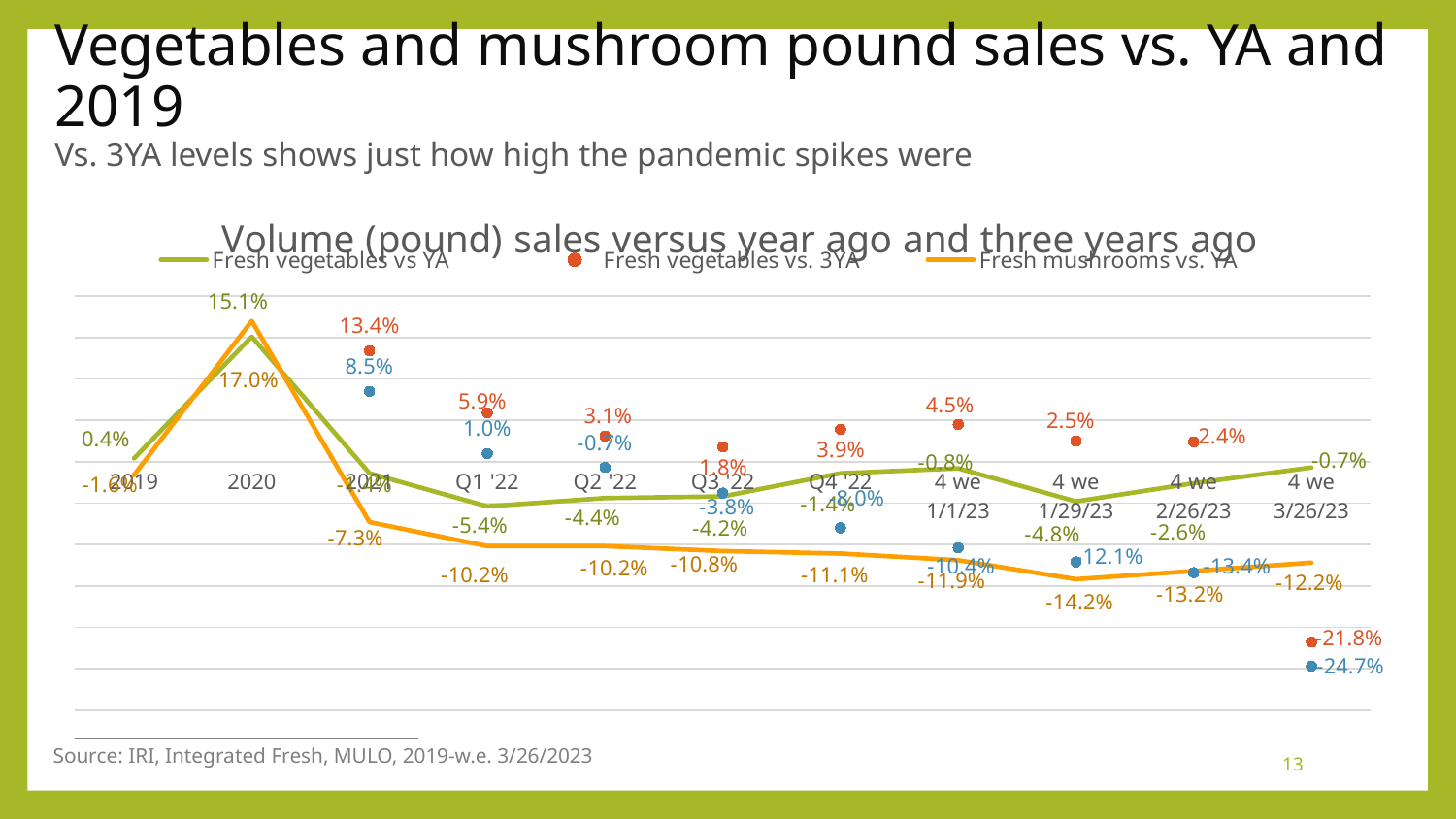
What is the difference between the Fresh mushrooms vs. YA values for Q4 '22 and the 4 weeks ending 1/1/23? 0.8 percentage points What is the title of the chart? Volume (pound) sales versus year ago and three years ago In which period is Fresh vegetables vs. 3YA at its highest? 2021 What is the value for Fresh vegetables vs. 3YA in the 4 weeks ending 1/1/23? 4.5% What is the value for Fresh mushrooms vs. YA in Q3 '22? -10.8% Which is larger for Fresh vegetables vs. 3YA: Q1 '22 or Q2 '22? Q1 '22 How many series does the chart legend list? 3 What is the value for Fresh vegetables vs YA in Q1 '22? -5.4% What is the value for Fresh vegetables vs. 3YA in the 4 weeks ending 3/26/23? -21.8% In which period is Fresh mushrooms vs. YA at its lowest? 4 we 1/29/23 What is the value for Fresh mushrooms vs. YA in the 4 weeks ending 1/29/23? -14.2% What kind of chart is shown on the slide? line chart